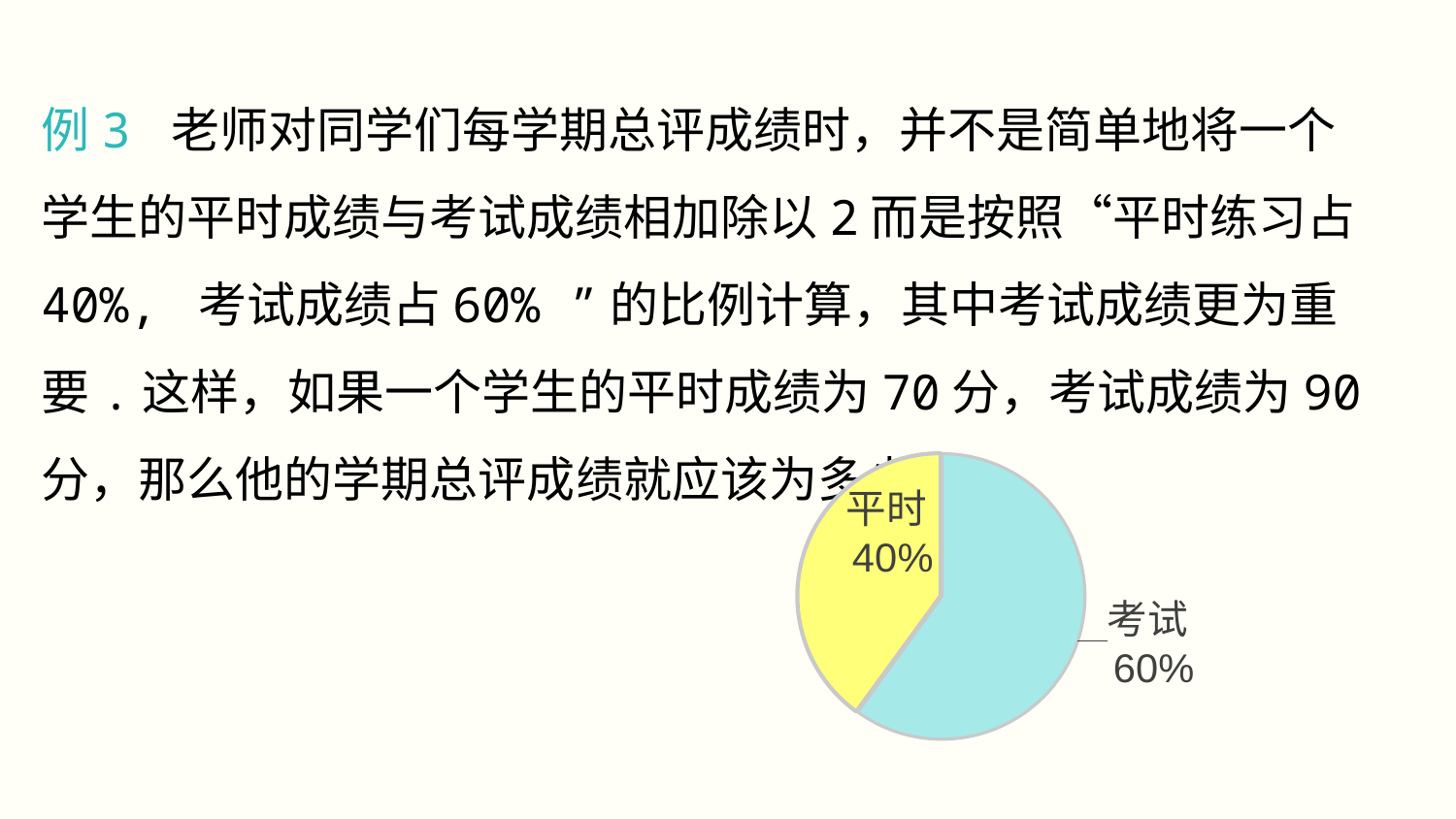
Which slice of the pie chart is the smallest? 平时 How many slices does the pie chart have? 2 Which is larger, the 考试 slice or the 平时 slice? 考试 Which slice of the pie chart is the largest? 考试 What colour is the 平时 slice of the pie chart? yellow Is the share for 平时 greater or less than 50%? less What kind of chart is shown on the slide? pie chart What share of the pie does 考试 take? 60% What colour is the 考试 slice of the pie chart? light blue What share of the pie does 平时 take? 40% What is the difference between the 考试 share and the 平时 share? 20%